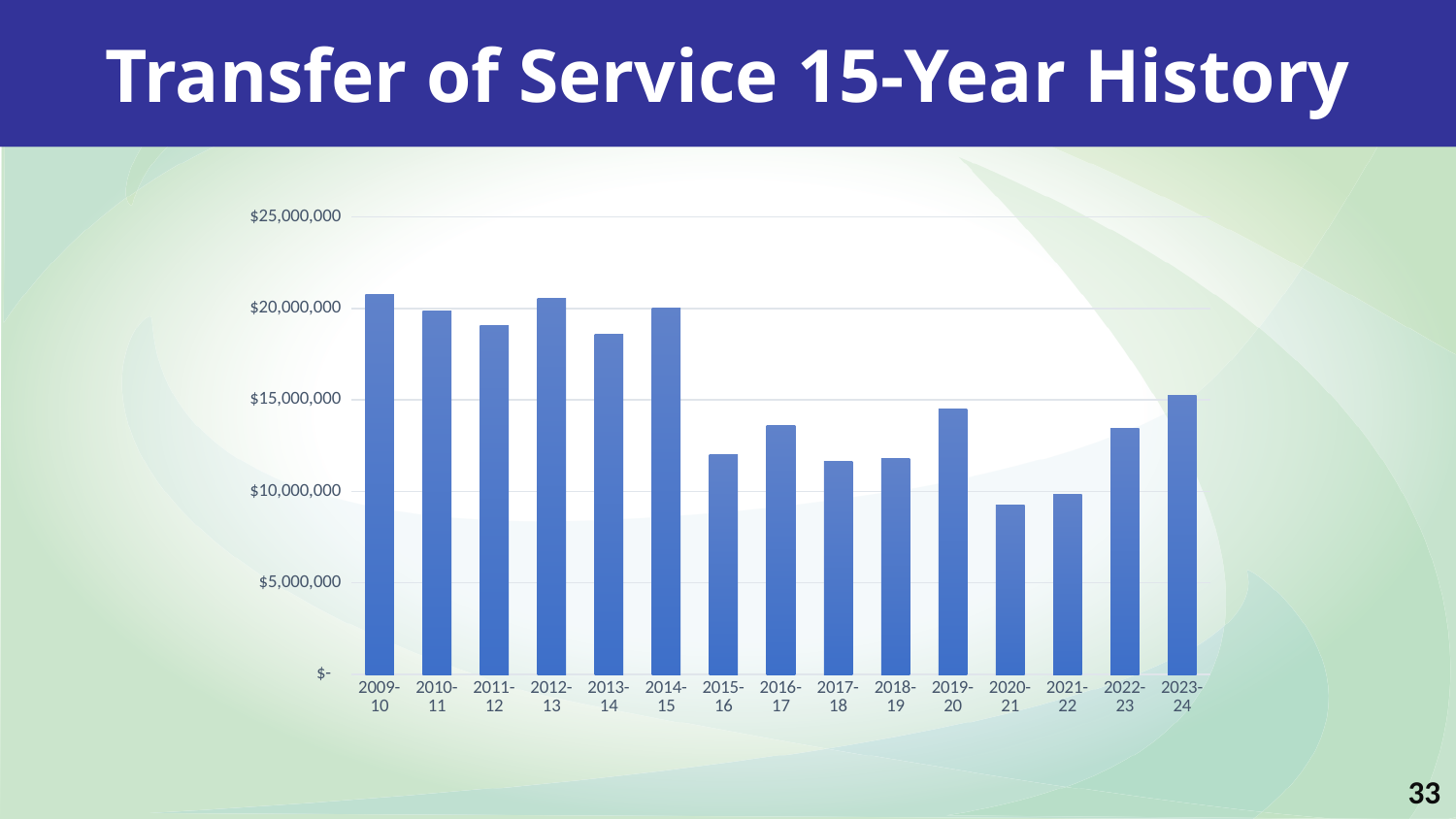
Is the value for 2023-24 greater or less than $10,000,000? greater How many fiscal years are plotted on the chart? 15 Is the value for 2015-16 greater or less than $15,000,000? less Which is larger, the value for 2009-10 or the value for 2015-16? 2009-10 Do the values rise or fall from 2020-21 to 2023-24? rise Is the value for 2014-15 greater or less than $15,000,000? greater What kind of chart is shown on the slide? Bar chart Which is larger, the value for 2019-20 or the value for 2020-21? 2019-20 Which fiscal year has the lowest value on the chart? 2020-21 What is the title of the slide containing the chart? Transfer of Service 15-Year History